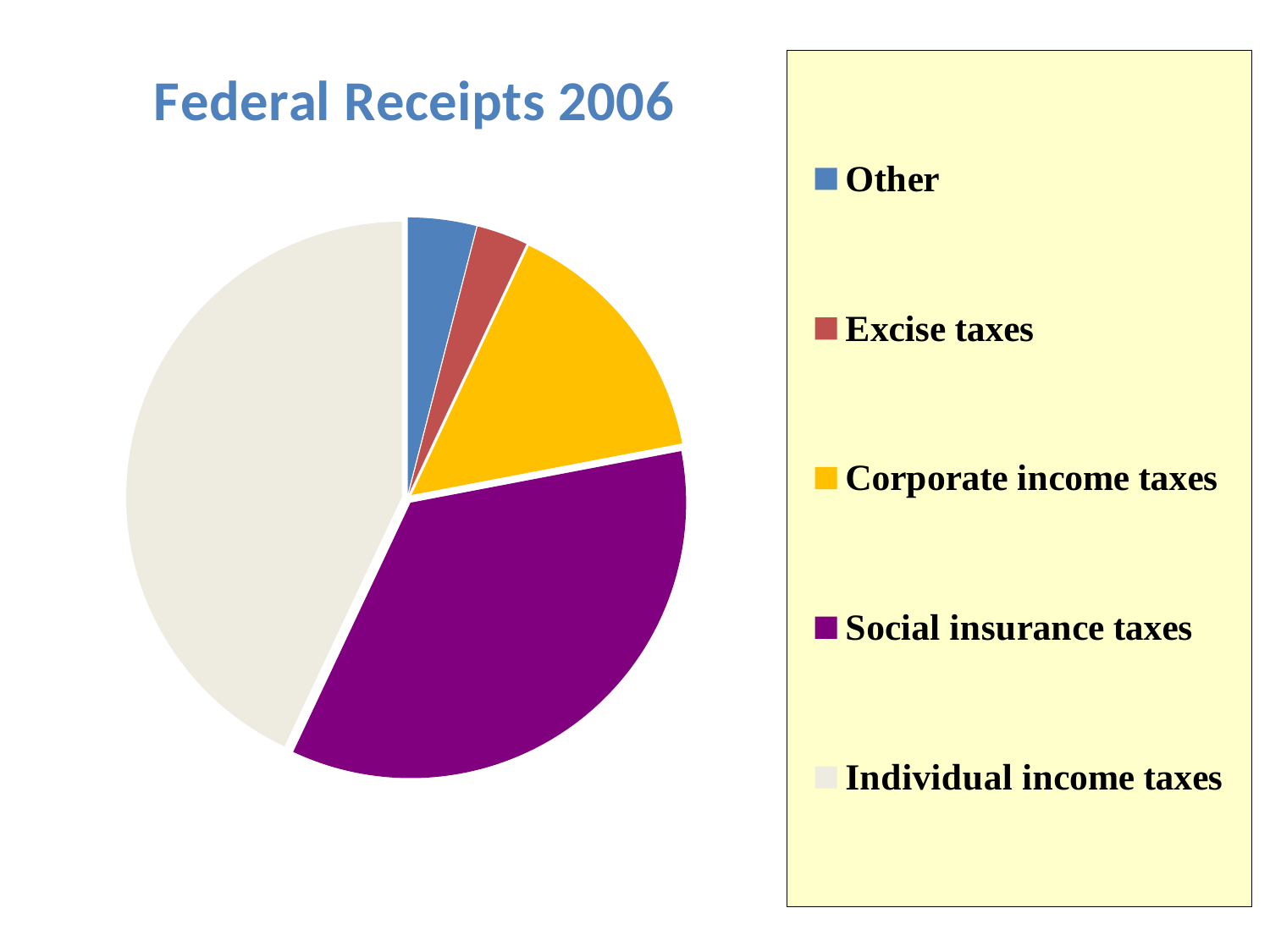
Which category has the largest slice of the pie? Individual income taxes Which category has the smallest slice of the pie? Excise taxes Which slice is larger, Individual income taxes or Social insurance taxes? Individual income taxes Which slice is larger, Corporate income taxes or Other? Corporate income taxes How many entries does the legend list? 5 Which slice is larger, Other or Excise taxes? Other Which category is shown in purple? Social insurance taxes How many categories does the pie chart have? 5 What kind of chart is shown on the slide? pie chart What is the title of the chart? Federal Receipts 2006